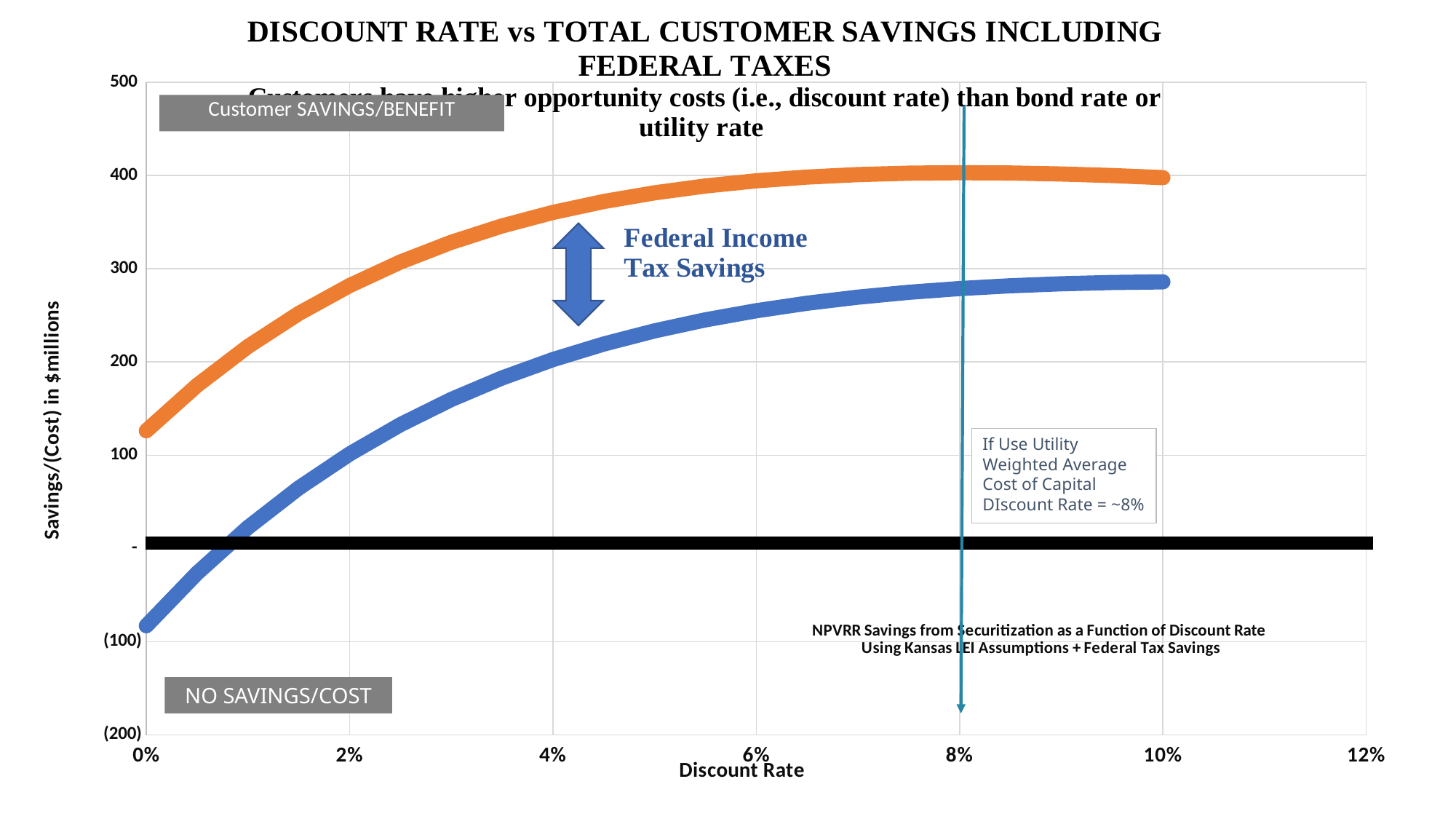
What kind of chart is shown on the slide? Line chart At a 6% discount rate, which line has the higher value, the orange line or the blue line? Orange line Is the value of the blue line at a 0% discount rate greater or less than 0? less How many lines are plotted on the chart? 2 Is the value of the blue line at a 10% discount rate greater or less than 300? less Is the value of the orange line at a 4% discount rate greater or less than 300? greater What is the label of the x axis? Discount Rate What is the title of the chart? DISCOUNT RATE vs TOTAL CUSTOMER SAVINGS INCLUDING FEDERAL TAXES Does the blue line rise or fall as the discount rate increases from 0% to 10%? Rises Does the orange line rise or fall as the discount rate increases from 0% to 6%? Rises